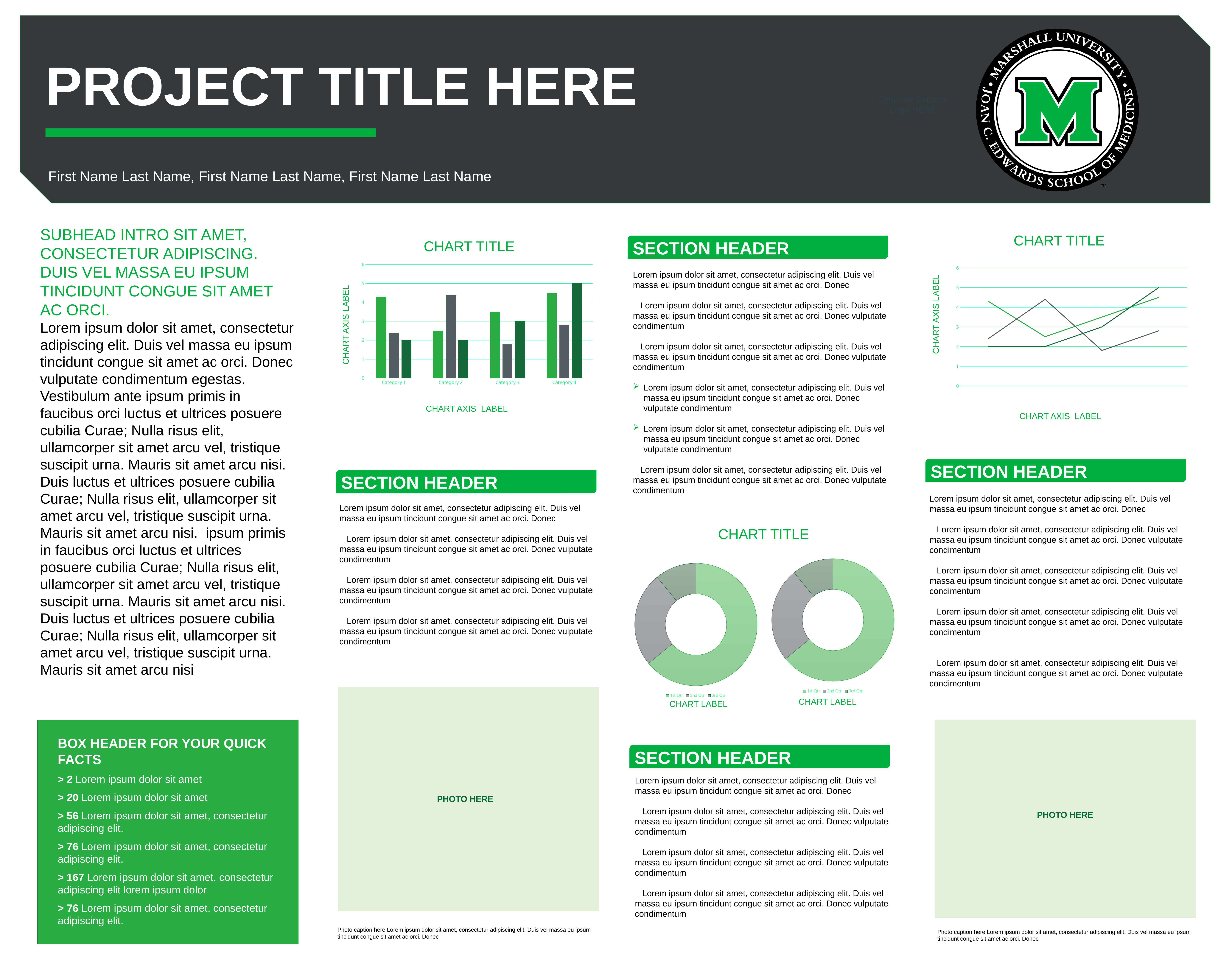
In the bar chart with Category 1 to Category 4, is the light green bar for Category 1 greater or less than 3? greater In the bar chart with Category 1 to Category 4, how many bars are plotted for each category? 3 How many slices does the right donut chart in the middle of the poster have? 3 In the bar chart with Category 1 to Category 4, is the gray bar for Category 3 greater or less than 3? less What is the title shown above the bar chart with Category 1 to Category 4? CHART TITLE In the bar chart with Category 1 to Category 4, which category contains the tallest bar? Category 4 What kind of chart is the chart at the top right of the poster? line chart In the bar chart with Category 1 to Category 4, for Category 2, which is taller: the gray bar or the light green bar? the gray bar What kind of chart is the chart with x-axis categories Category 1 to Category 4? bar chart In the bar chart with Category 1 to Category 4, how many categories are shown on the x axis? 4 How many lines are plotted in the line chart at the top right of the poster? 3 In the left donut chart in the middle of the poster, which legend entry corresponds to the largest slice? 1st Qtr